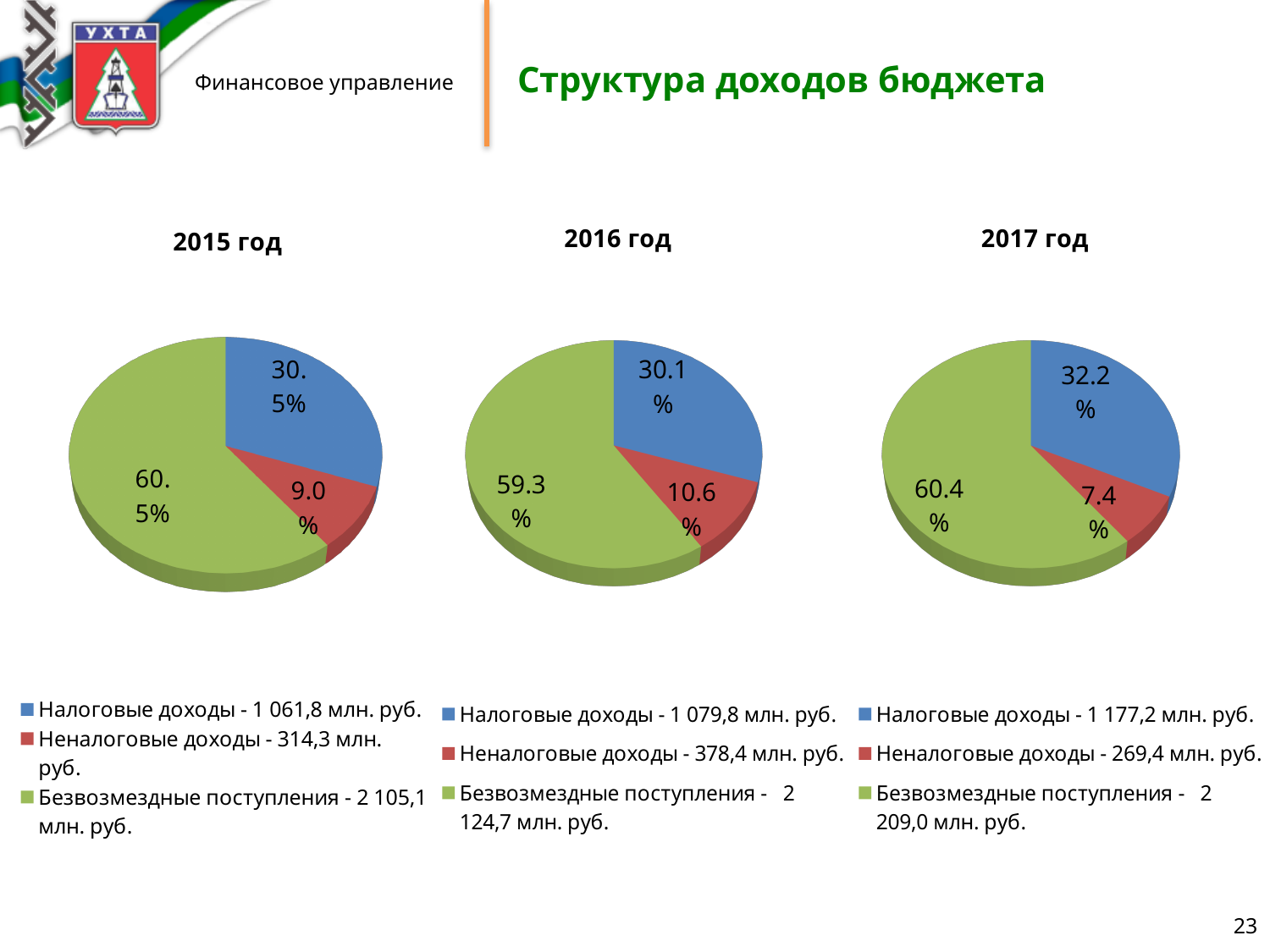
Is the Неналоговые доходы share larger in the 2016 год chart or the 2017 год chart? 2016 год In the 2015 год chart, what share does Налоговые доходы have? 30.5% In the 2017 год chart, what is the difference in percentage points between Безвозмездные поступления and Налоговые доходы? 28.2 In the 2015 год chart, what share does Неналоговые доходы have? 9.0% In the 2016 год chart, what share does Безвозмездные поступления have? 59.3% In the 2017 год chart legend, what amount is given for Налоговые доходы? 1 177,2 млн. руб. In the 2016 год chart, which category has the largest slice? Безвозмездные поступления In the 2017 год chart, which category has the smallest slice? Неналоговые доходы What kind of chart is used for the 2015 год chart? pie chart How many slices does the 2015 год pie chart have? 3